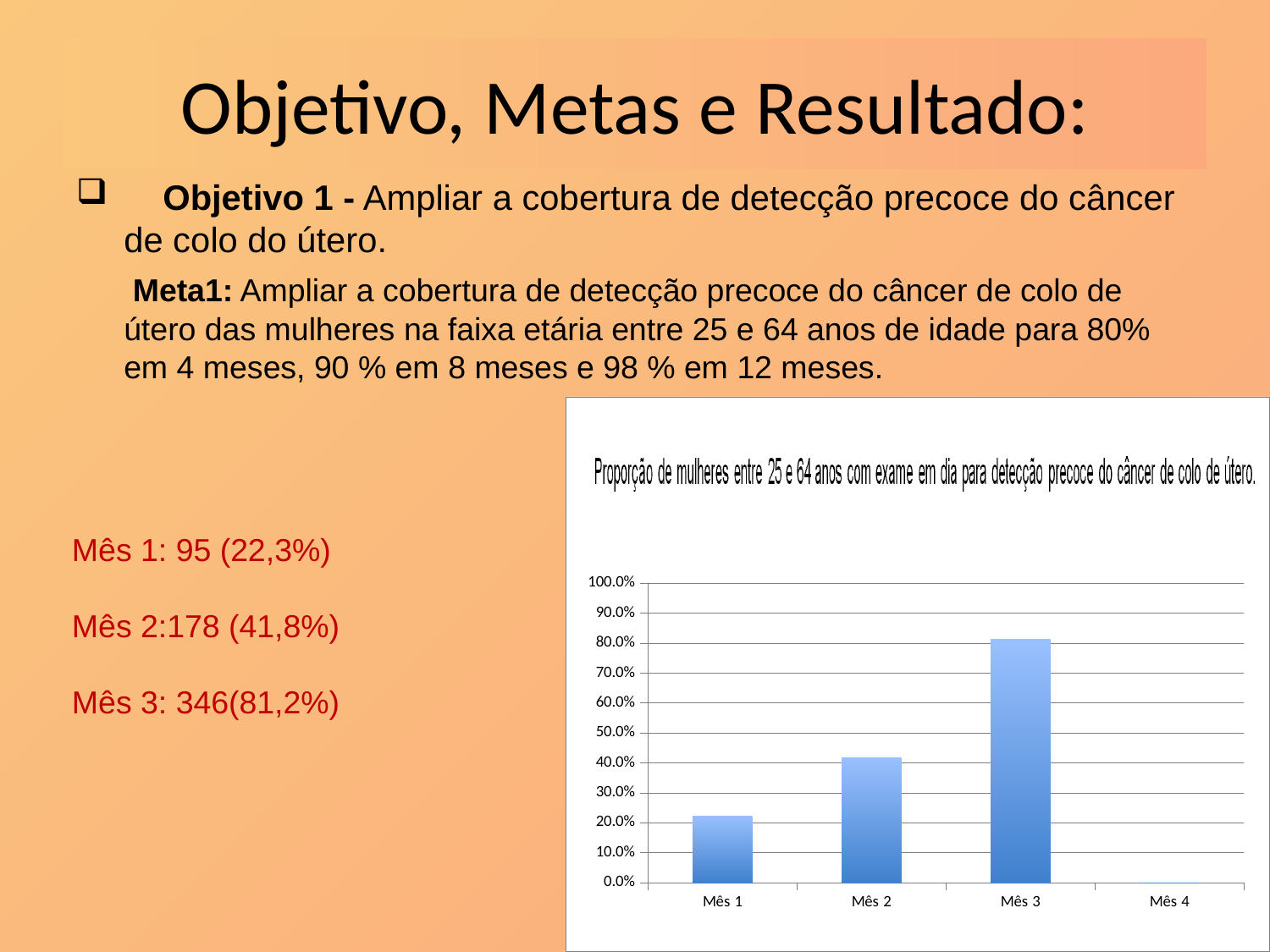
How many categories are shown on the x axis of the chart? 4 What kind of chart is shown on the slide? bar chart Do the bar values rise or fall from Mês 1 to Mês 3? rise What is the highest value shown on the chart's y axis? 100.0% Which month with a plotted bar has the lowest value in the chart? Mês 1 Is the value for Mês 3 greater or less than 80.0%? greater According to the slide text, what percentage is given for Mês 3? 81,2% Is the value for Mês 1 greater or less than 30.0%? less Which is larger, the value for Mês 2 or the value for Mês 3? Mês 3 Is the value for Mês 2 greater or less than 40.0%? greater Which month has the highest bar in the chart? Mês 3